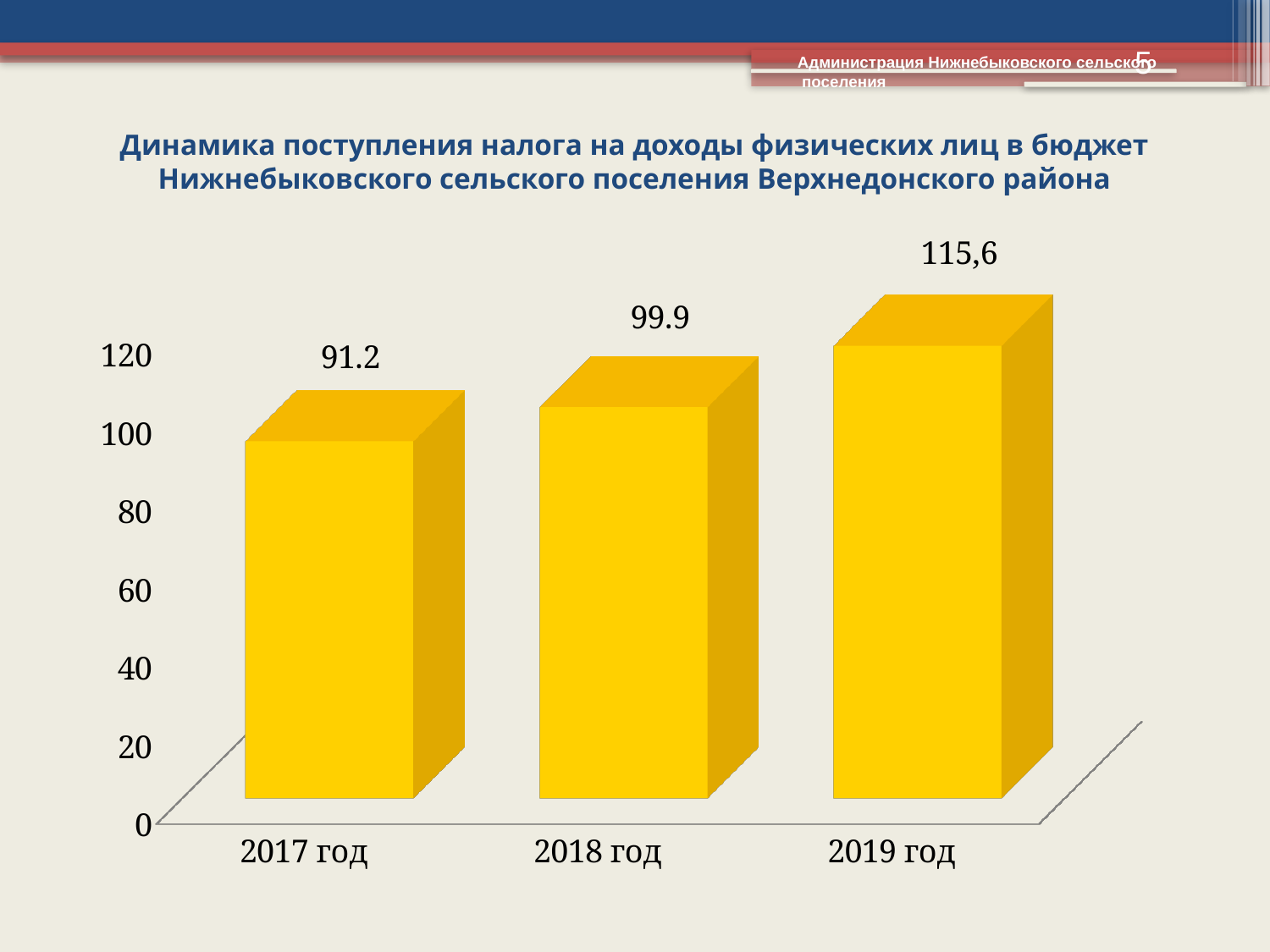
Which year has the lowest value? 2017 год Which year has the highest value? 2019 год Which is larger, the value for 2018 год or the value for 2019 год? 2019 год What is the value for 2017 год? 91.2 Is the value for 2019 год greater or less than 100? greater What is the difference between the values for 2018 год and 2017 год? 8.7 How many years are shown on the chart? 3 Do the values rise or fall from 2017 год to 2019 год? rise Is the value for 2017 год greater or less than 100? less What kind of chart is shown on the slide? bar chart What is the value for 2019 год? 115,6 What is the value for 2018 год? 99.9